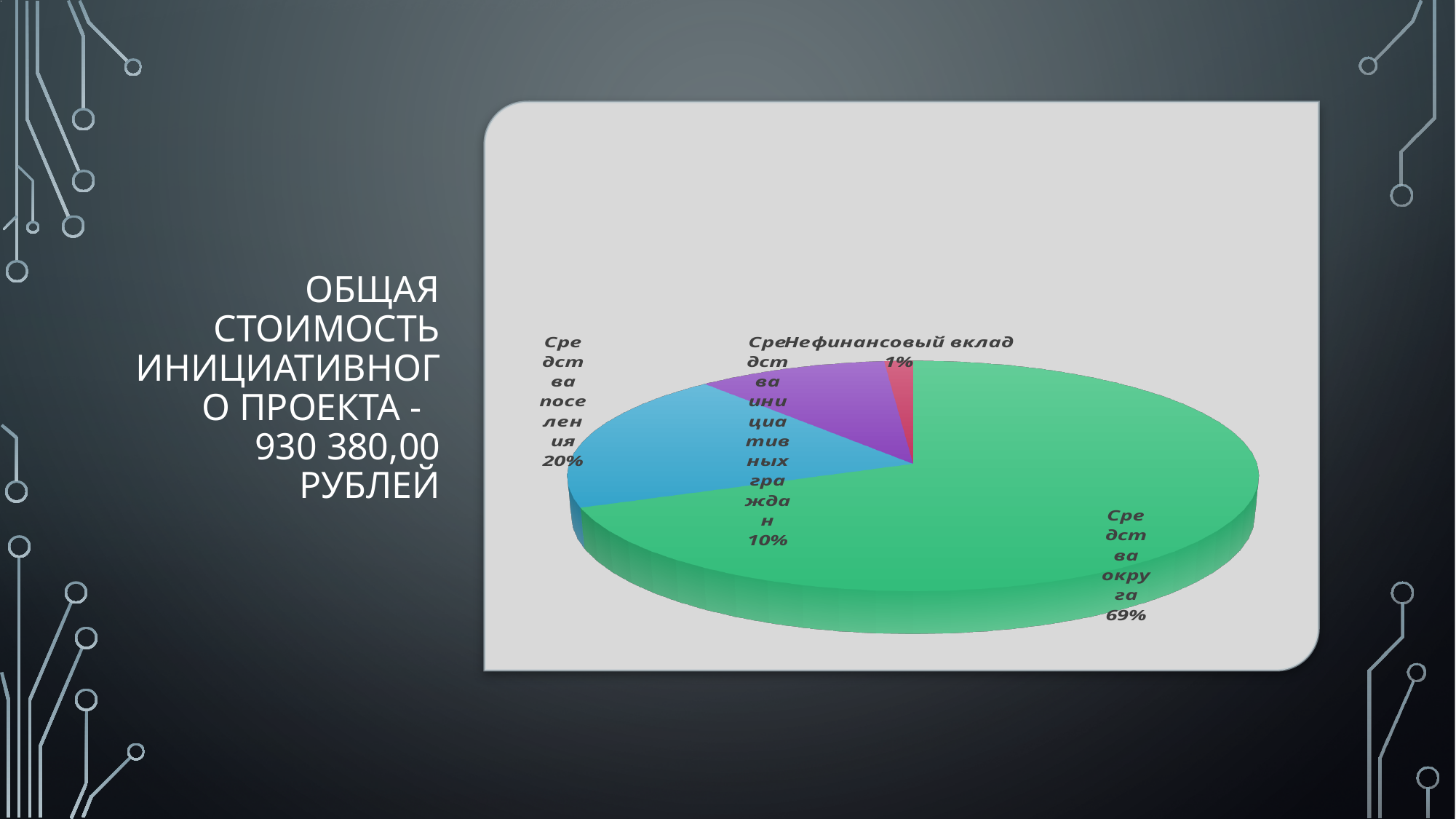
What total project cost is stated in the slide title next to the chart? 930 380,00 рублей Which slice of the pie chart is the smallest? Нефинансовый вклад What share of the pie is labelled "Средства округа"? 69% What share of the pie is labelled "Средства поселения"? 20% What share of the pie is labelled "Средства инициативных граждан"? 10% Which is larger: the share for "Средства поселения" or the share for "Средства инициативных граждан"? Средства поселения What is the difference in percentage points between "Средства округа" and "Средства поселения"? 49 What kind of chart is shown on the slide? pie chart How many slices does the pie chart have? 4 What colour is the slice for "Средства округа"? green Which slice of the pie chart is the largest? Средства округа